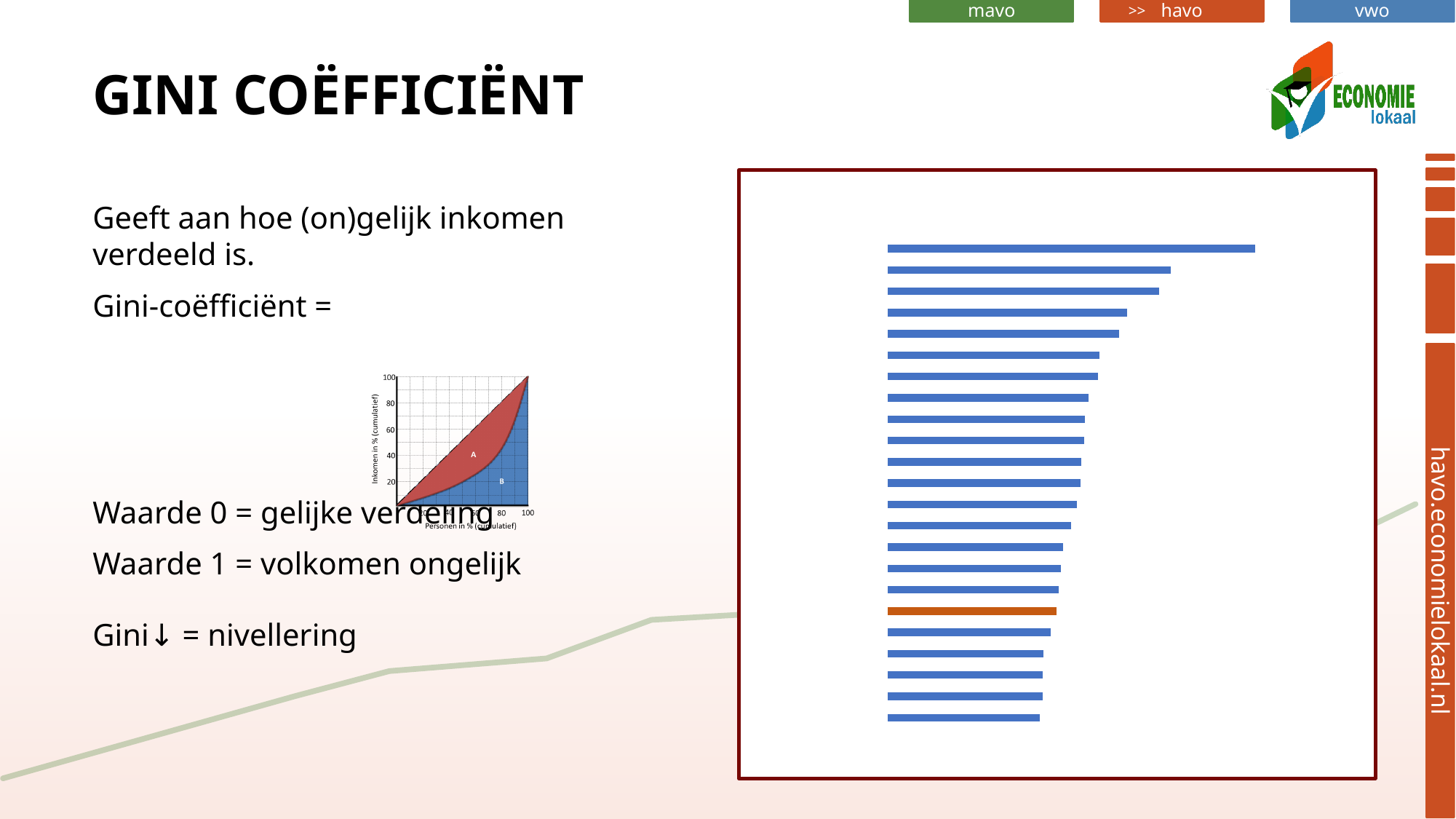
What kind of chart is shown in the large box on the right of the slide? bar chart In the large bar chart on the right, is the orange bar longer or shorter than the top bar? shorter In the small chart on the left of the slide, what is the label on the vertical axis? Inkomen in % (cumulatief) In the large bar chart on the right, what colour is the single highlighted bar? orange In the small chart on the left of the slide, what is the highest value shown on the horizontal axis? 100 In the large bar chart on the right, do the bar lengths increase or decrease from the top bar to the bottom bar? decrease How many bars does the large bar chart on the right contain? 23 In the large bar chart on the right, how many bars are orange rather than blue? 1 In the large bar chart on the right, which bar is the longest? the top bar In the large bar chart on the right, which is longer: the top bar or the second bar from the top? the top bar